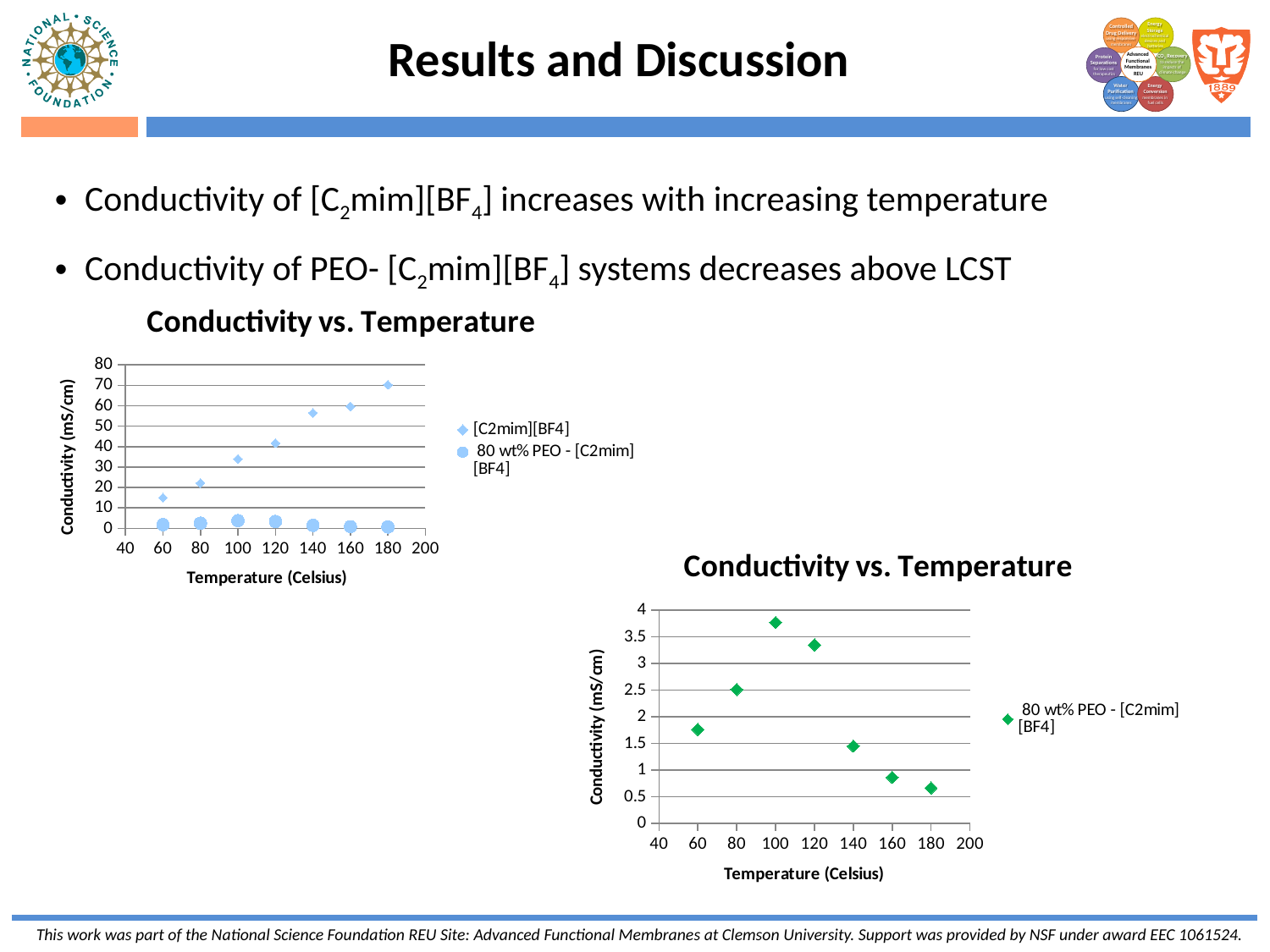
In the lower-right chart, is the conductivity at 100 Celsius greater or less than 3.5? greater How many series does the legend of the lower-right chart list? 1 What is the y-axis label of the lower-right chart? Conductivity (mS/cm) In the lower-right chart, at which temperature is the conductivity of 80 wt% PEO - [C2mim][BF4] lowest? 180 In the upper-left chart, is the conductivity of [C2mim][BF4] at 180 Celsius greater or less than 60? greater In the lower-right chart, how many data points are plotted? 7 How many series does the legend of the upper-left chart list? 2 In the lower-right chart, which has the higher conductivity: 80 Celsius or 160 Celsius? 80 Celsius In the upper-left chart, does the conductivity of [C2mim][BF4] rise or fall as temperature increases? rise In the lower-right chart, is the conductivity at 180 Celsius greater or less than 1? less What type of chart is the upper-left chart on the slide? scatter chart In the lower-right chart, at which temperature is the conductivity of 80 wt% PEO - [C2mim][BF4] highest? 100